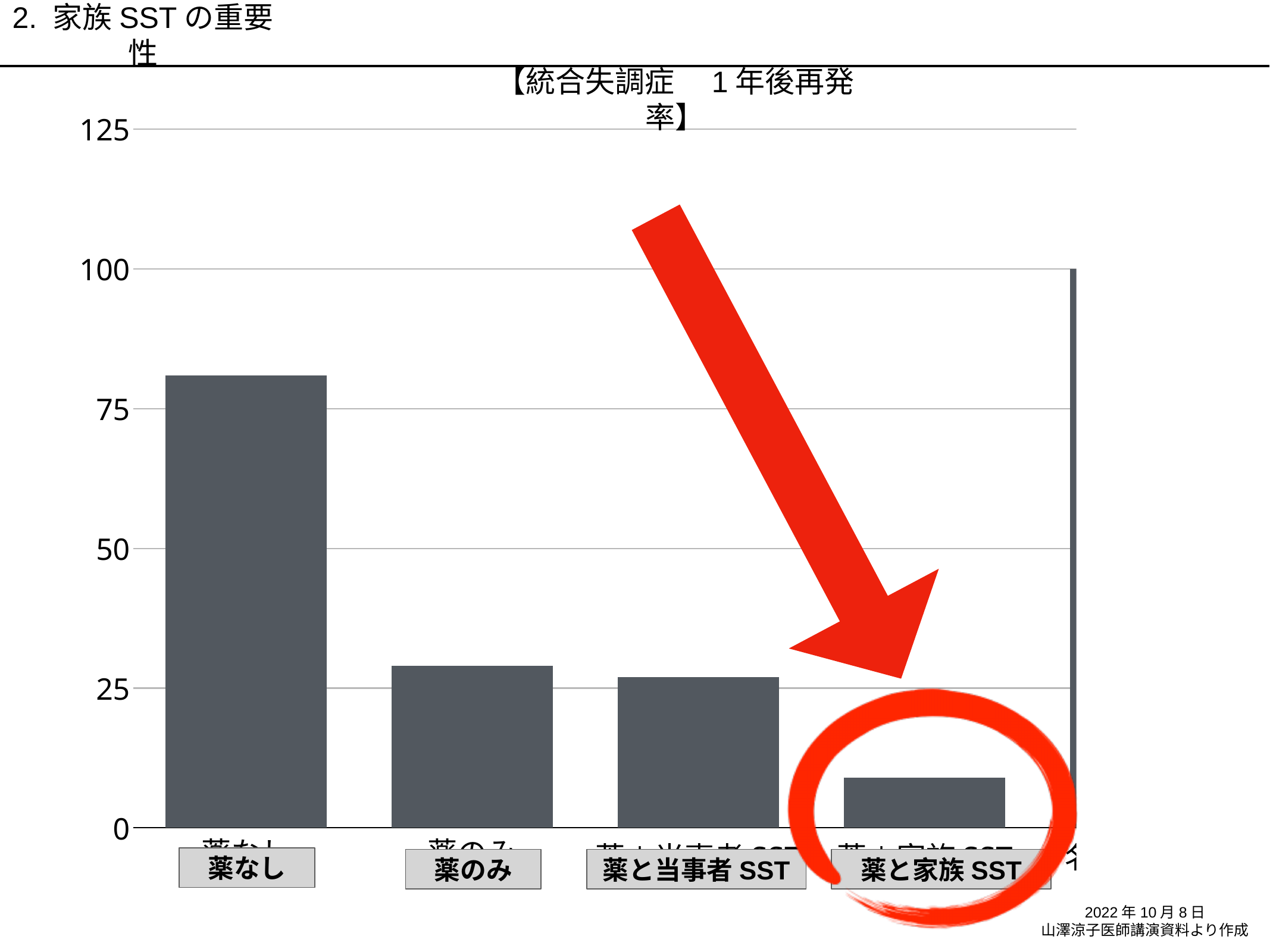
Which is larger, the value for 薬なし or the value for 薬のみ? 薬なし Which category's bar is circled in red on the slide? 薬と家族SST Which category has the lowest value in the chart? 薬と家族SST What kind of chart is shown on the slide? bar chart Is the value for 薬なし greater or less than 75? greater Is the value for 薬なし greater or less than 100? less Is the value for 薬のみ greater or less than 50? less Which is larger, the value for 薬と当事者SST or the value for 薬と家族SST? 薬と当事者SST